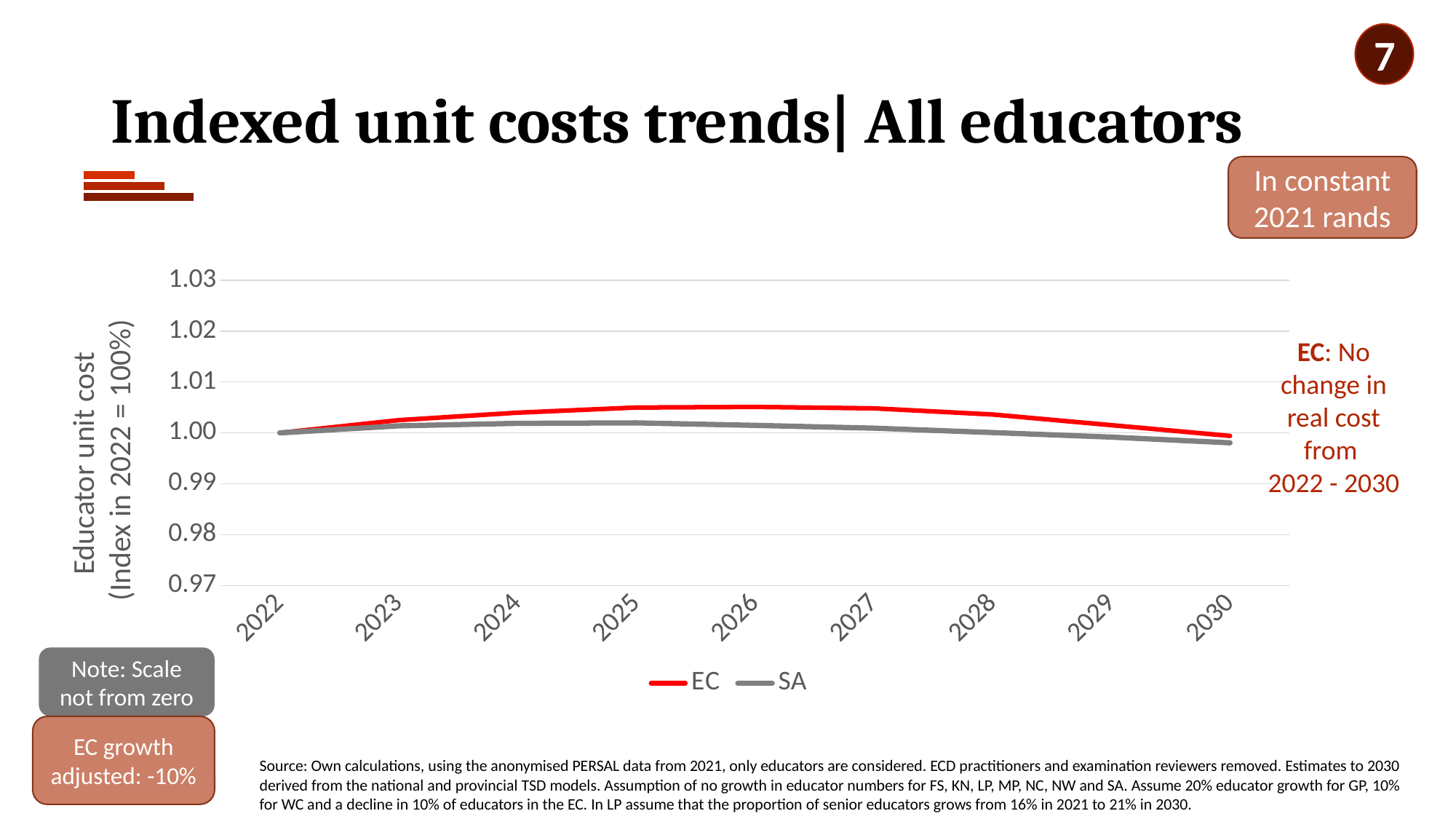
What is the value of the EC index in 2022? 1.00 In 2026, which series has the higher value, EC or SA? EC Which series are listed in the legend? EC and SA Is the value for EC in 2026 greater or less than 1.00? greater What colour is the EC line? red How many years are shown along the x axis? 9 Is the value for EC in 2026 greater or less than 1.01? less Between 2026 and 2030, does the EC line rise or fall? fall Between 2022 and 2025, does the SA line rise or fall? rise What kind of chart is shown on the slide? line chart How many series does the legend list? 2 Is the value for SA in 2025 greater or less than 1.01? less